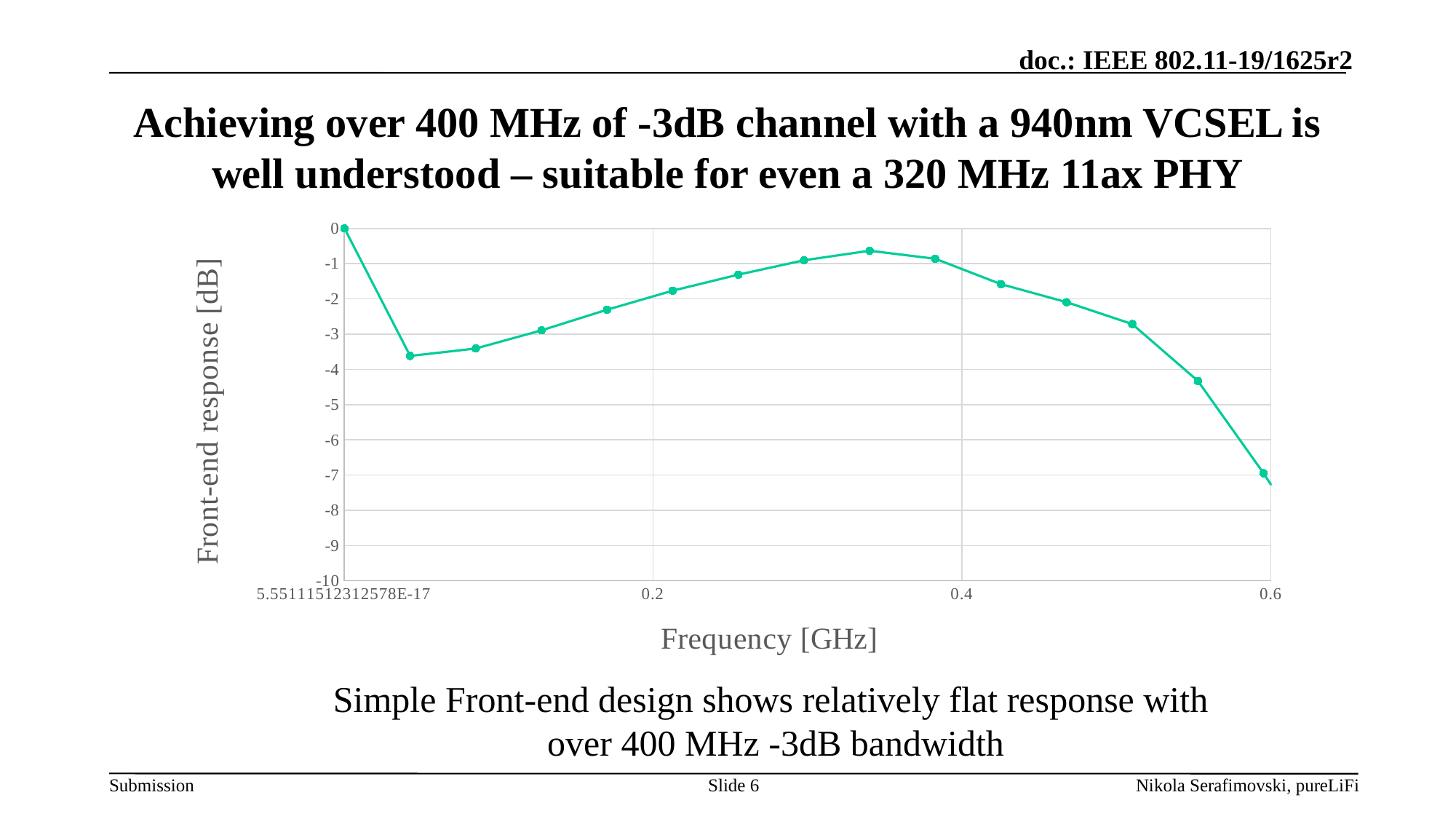
What is the label of the y axis of the chart? Front-end response [dB] Which plotted point has the highest front-end response? the first point, at the leftmost frequency What kind of chart is shown on the slide? line chart What is the front-end response value at the first plotted point (the leftmost point on the x axis)? 0 What is the label of the x axis of the chart? Frequency [GHz] Is the front-end response at 0.2 GHz greater or less than -3 dB? greater Is the front-end response at 0.6 GHz greater or less than -5 dB? less How many data points are plotted on the line? 15 Is the front-end response at 0.2 GHz higher or lower than at 0.6 GHz? higher Does the front-end response rise or fall as frequency increases from 0.4 GHz to 0.6 GHz? fall Is the front-end response at 0.4 GHz greater or less than -2 dB? greater Which plotted point has the lowest front-end response? the last point, near 0.6 GHz